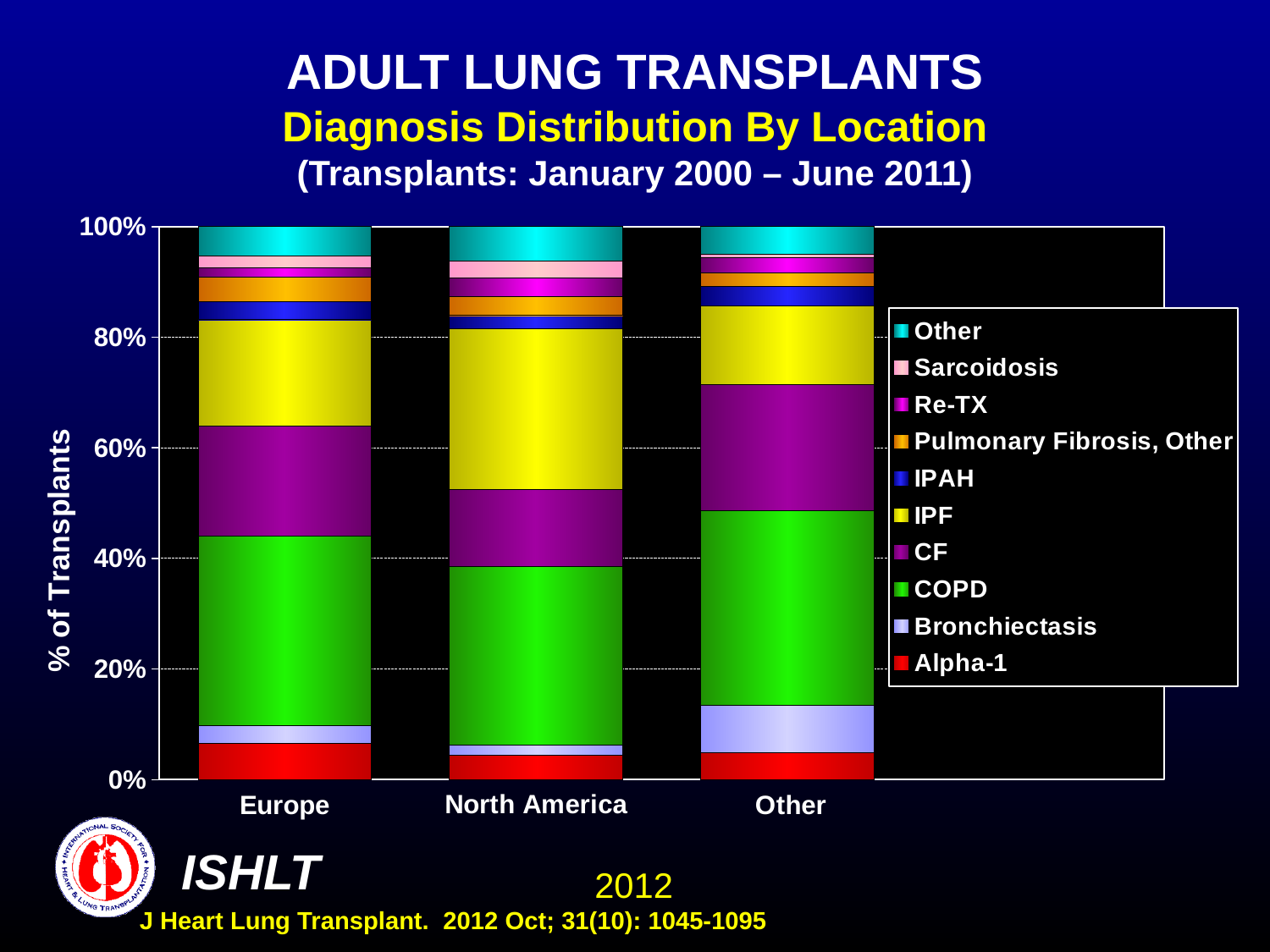
Which location has the largest CF segment? Other Is the COPD segment for Other greater or less than 20%? greater How many diagnosis series does the legend list? 10 Which location has the largest Bronchiectasis segment? Other Is the CF segment larger for Other or for North America? Other Which legend entry is shown in green? COPD What kind of chart is shown on the slide? Stacked bar chart How many locations are shown on the x axis of the chart? 3 What is the label of the y axis? % of Transplants Which location has the largest IPF segment? North America Is the CF segment for Europe greater or less than 40%? less Is the IPF segment larger for North America or for Europe? North America